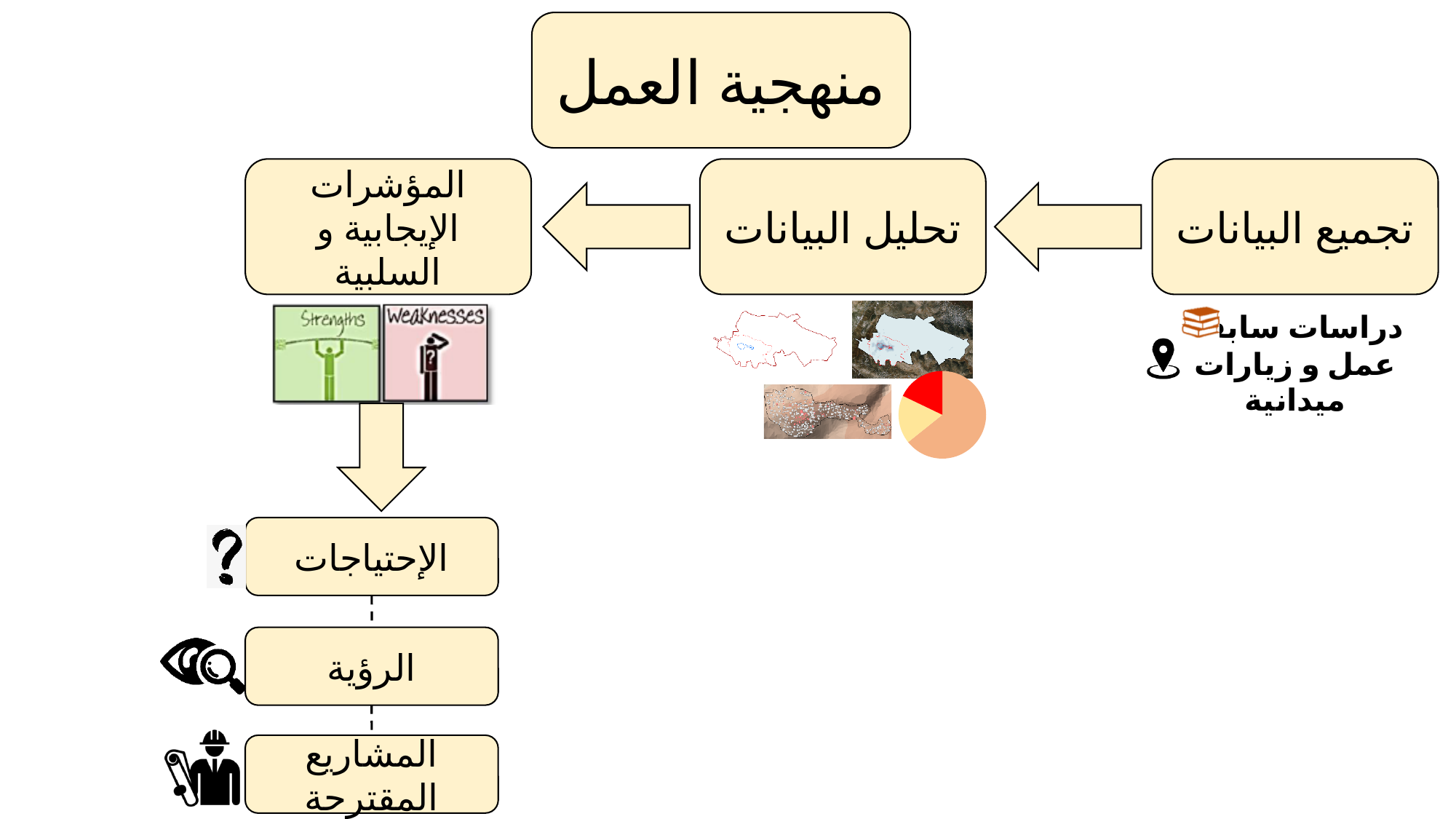
Which slice of the pie chart is the largest, by colour? the orange (peach) slice How many slices does the pie chart on the slide have? 3 Does the pie chart on the slide have a legend? No What colours are the slices of the pie chart on the slide? red, yellow and orange Is the orange slice of the pie chart larger or smaller than the red slice? larger Is the orange slice of the pie chart larger or smaller than the yellow slice? larger What kind of chart is shown on the slide, below the data analysis box? pie chart